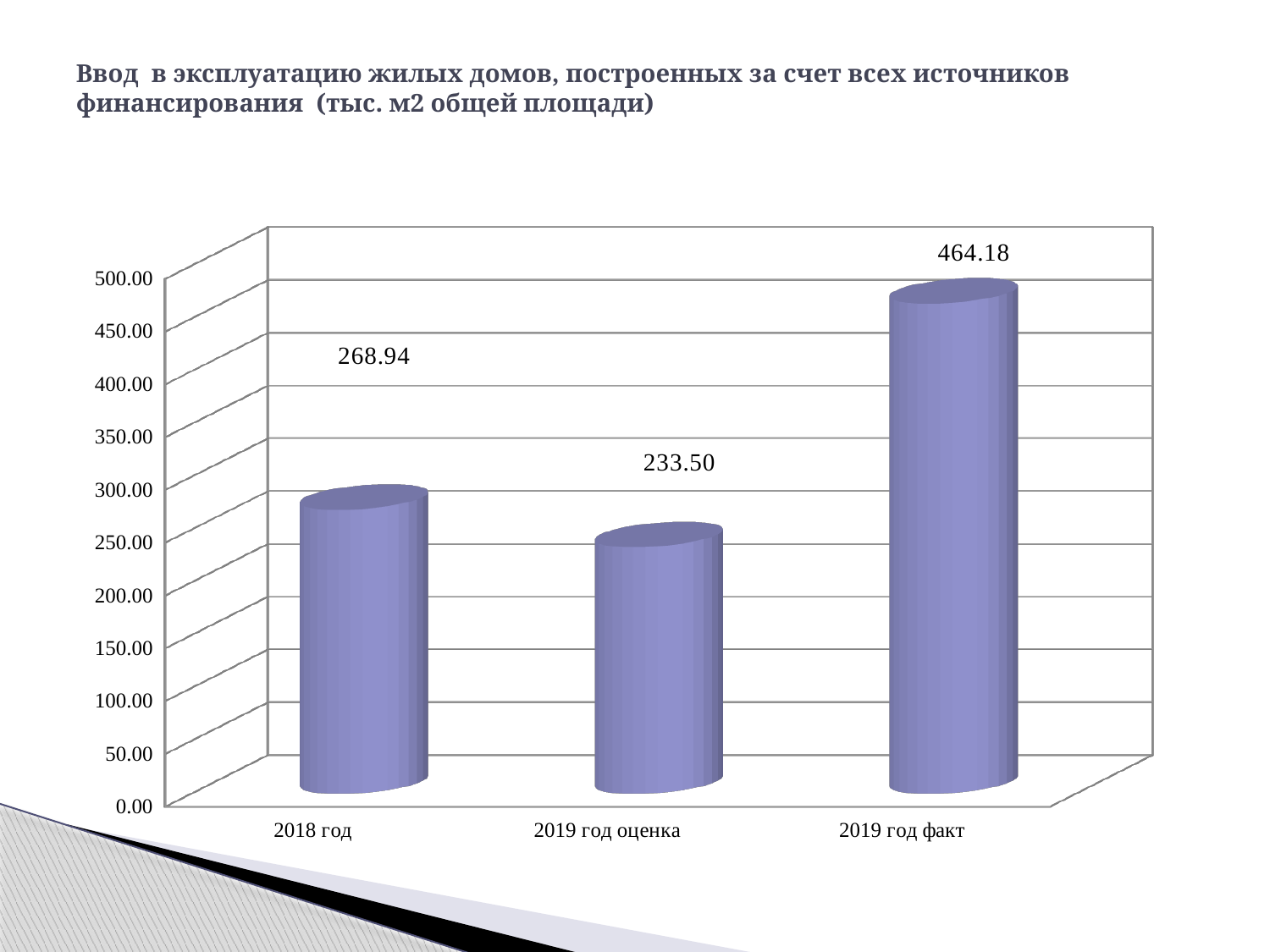
What is the value for 2019 год оценка? 233.50 Which category has the lowest value? 2019 год оценка What is the difference between the values for 2019 год факт and 2019 год оценка? 230.68 What kind of chart is shown on the slide? bar chart Which category has the highest value? 2019 год факт How many categories are shown on the x axis? 3 Is the value for 2019 год факт greater or less than 450.00? greater What is the difference between the values for 2018 год and 2019 год оценка? 35.44 Which is larger, the value for 2018 год or the value for 2019 год оценка? 2018 год What unit of measurement is given in the chart title? тыс. м2 общей площади What is the value for 2019 год факт? 464.18 What is the value for 2018 год? 268.94